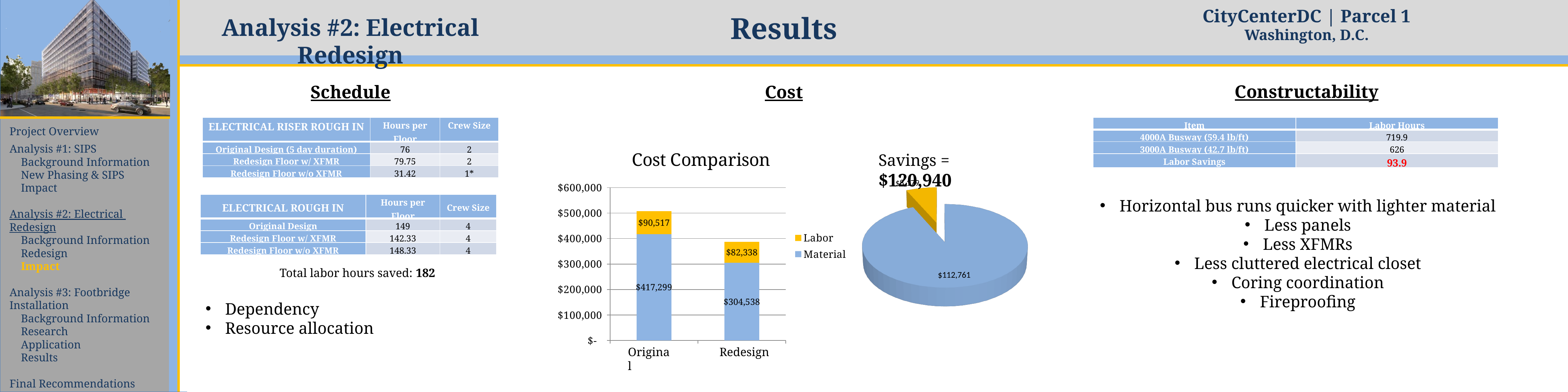
In the Cost Comparison chart, what is the difference between the Material values for Original and Redesign? $112,761 In the Cost Comparison chart, how many categories are shown on the x axis? 2 In the Cost Comparison chart, which category has the larger Labor value, Original or Redesign? Original In the Cost Comparison chart, what is the total of the stacked bar for Redesign? $386,876 In the Cost Comparison chart, how many series does the legend list? 2 In the Cost Comparison chart, what is the Labor value for Original? $90,517 In the Cost Comparison chart, what is the Material value for Redesign? $304,538 In the Cost Comparison chart, which colour represents the Labor series? Yellow In the Cost Comparison chart, what is the total of the stacked bar for Original? $507,816 What kind of chart is the Cost Comparison chart? Stacked bar chart In the Cost Comparison chart, what is the Labor value for Redesign? $82,338 In the Cost Comparison chart, what is the Material value for Original? $417,299